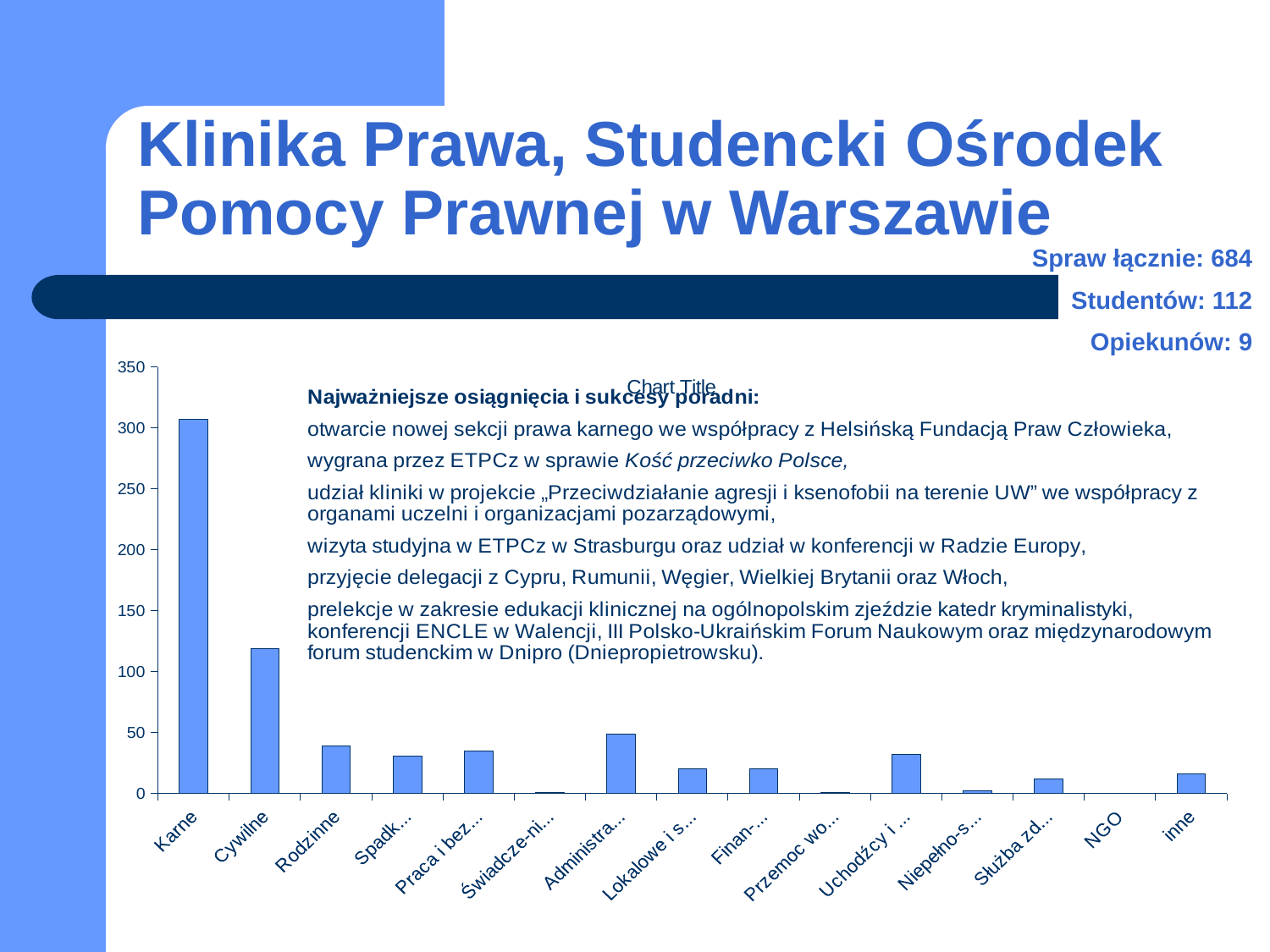
Is the value for Cywilne greater or less than 100? greater What kind of chart is shown on the slide? bar chart Which has the larger value, Cywilne or Rodzinne? Cywilne Is the value for Administra... greater or less than 100? less What title text is displayed above the chart? Chart Title Is the value for Karne greater or less than 250? greater Which category has the highest bar in the chart? Karne How many categories are shown on the x axis of the chart? 15 Which has the larger value, Uchodźcy i ... or Służba zd...? Uchodźcy i ... Which has the larger value, Karne or Cywilne? Karne